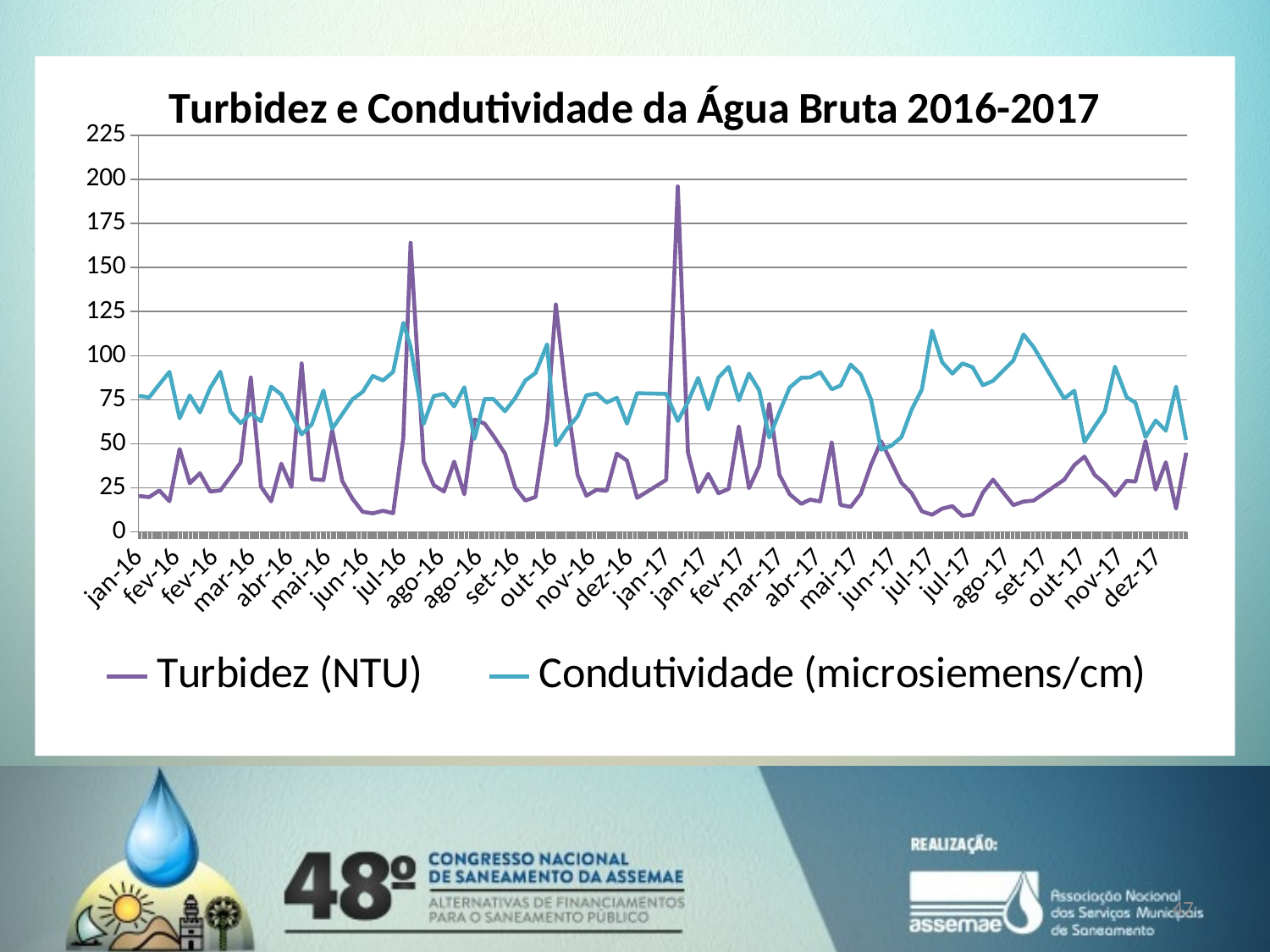
Is the Condutividade (microsiemens/cm) peak near jul-17 greater or less than 100? greater At jan-16, which series has the higher value, Turbidez (NTU) or Condutividade (microsiemens/cm)? Condutividade (microsiemens/cm) Which series reaches the highest value anywhere on the chart? Turbidez (NTU) Is the Turbidez (NTU) value at jan-16 greater or less than 50? less Are the lowest Turbidez (NTU) values around jun-16 greater or less than 25? less What is the title of the chart? Turbidez e Condutividade da Água Bruta 2016-2017 How many series does the legend list? 2 What kind of chart is shown on the slide? line chart Which colour is used for the Condutividade (microsiemens/cm) series? blue